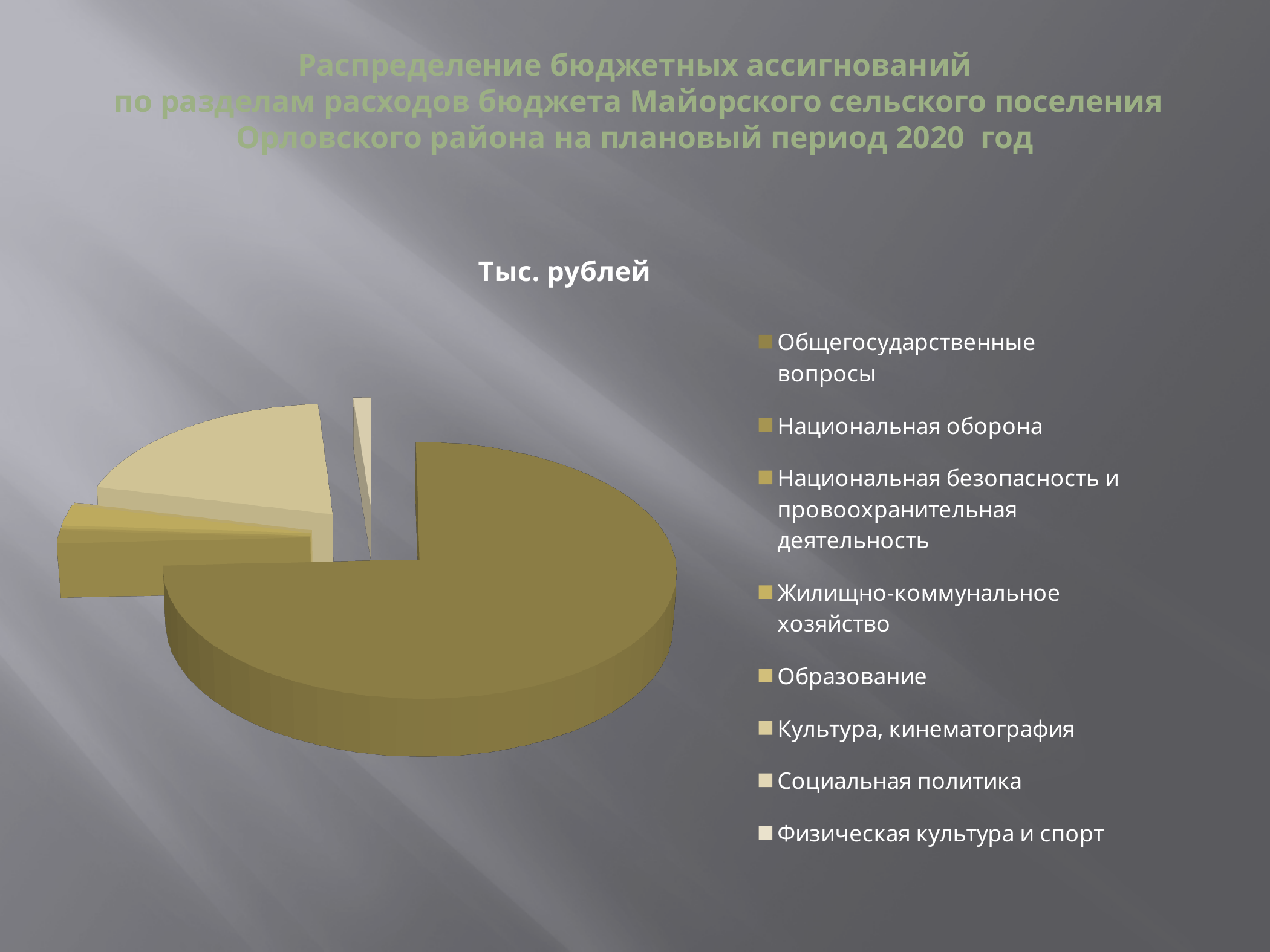
Which category has the largest slice in the pie chart? Общегосударственные вопросы What kind of chart is shown on the slide? pie chart What is the first category listed in the legend of the pie chart? Общегосударственные вопросы What is the title shown above the pie chart? Тыс. рублей How many categories does the legend of the pie chart list? 8 Does the slice for Общегосударственные вопросы take up more or less than half of the pie? more